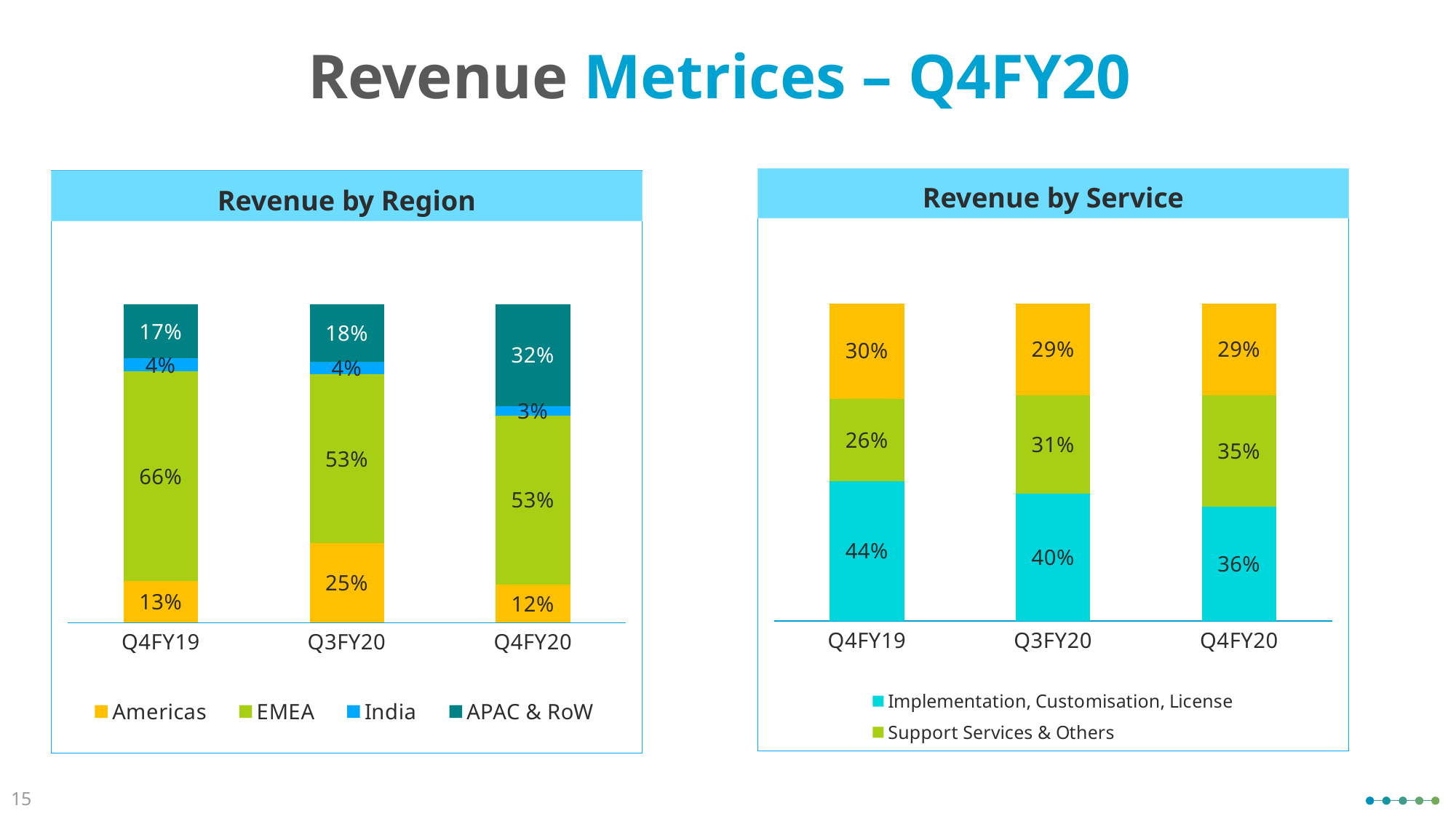
In the Revenue by Service chart, what is the Support Services & Others share for Q4FY20? 35% In the Revenue by Region chart, which quarter has the highest APAC & RoW share? Q4FY20 In the Revenue by Region chart, what is the Americas share for Q3FY20? 25% In the Revenue by Region chart, does the India share rise or fall from Q3FY20 to Q4FY20? fall In the Revenue by Region chart, what is the difference between the Americas share in Q3FY20 and in Q4FY20? 13% In the Revenue by Service chart, what is the Implementation, Customisation, License share for Q4FY19? 44% In the Revenue by Service chart, does the Implementation, Customisation, License share rise or fall across the three quarters? fall In the Revenue by Region chart, what is the APAC & RoW share for Q4FY20? 32% In the Revenue by Region chart, what is the EMEA share for Q4FY19? 66% What kind of chart is the Revenue by Service chart? stacked bar chart In the Revenue by Service chart, how many quarters are shown on the x axis? 3 In the Revenue by Region chart, how many series does the legend list? 4